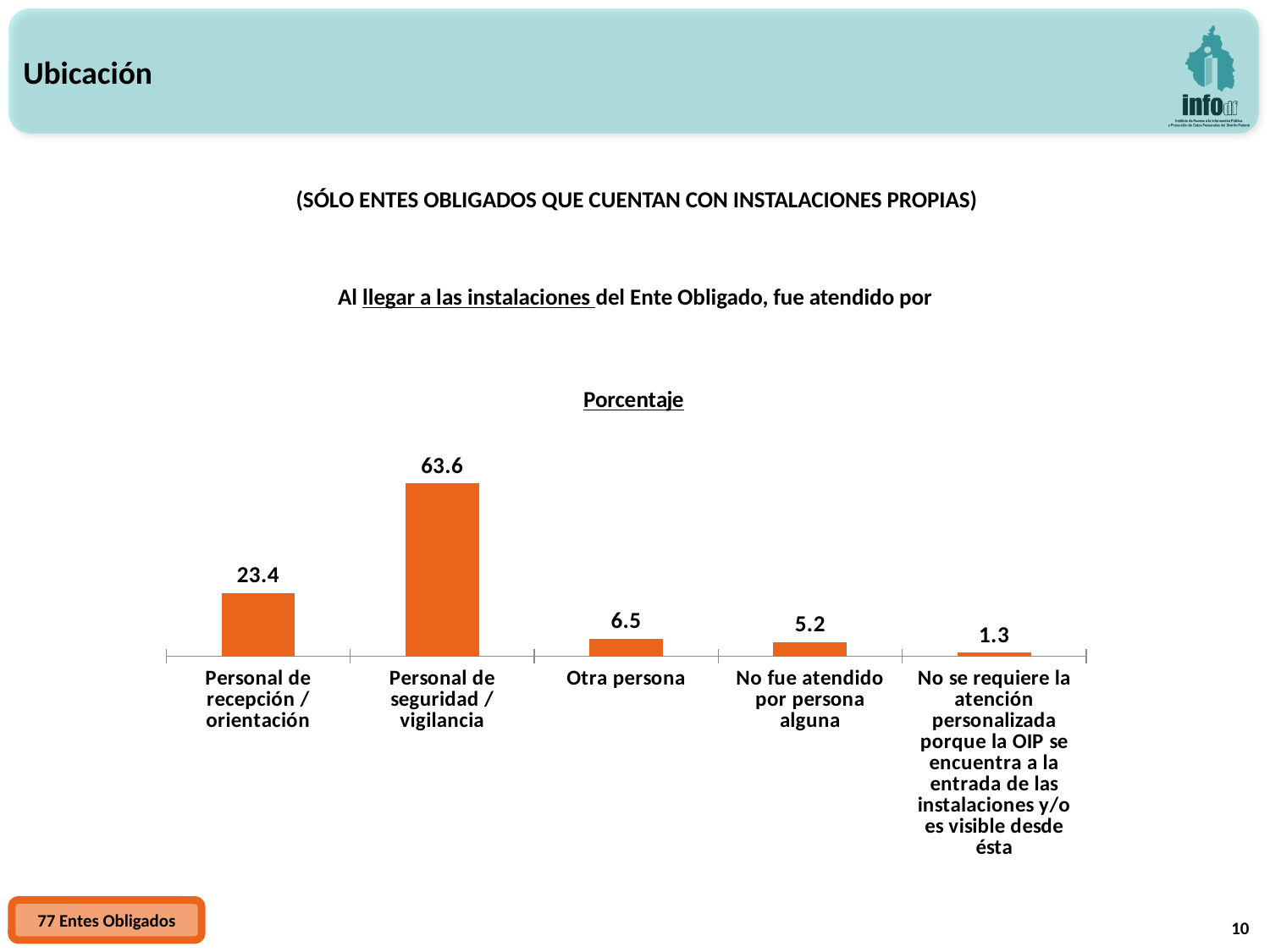
What is the value for "Otra persona"? 6.5 Which category has the lowest value? No se requiere la atención personalizada porque la OIP se encuentra a la entrada de las instalaciones y/o es visible desde ésta Which category has the highest value? Personal de seguridad / vigilancia What kind of chart is shown on the slide? Bar chart Which is larger, the value for "Otra persona" or the value for "No fue atendido por persona alguna"? Otra persona How many categories are shown in the chart? 5 What is the value for "No fue atendido por persona alguna"? 5.2 What is the label shown above the chart indicating the unit of the values? Porcentaje What is the difference between the values for "Personal de seguridad / vigilancia" and "Personal de recepción / orientación"? 40.2 What is the value for "Personal de recepción / orientación"? 23.4 What is the difference between the values for "Otra persona" and "No fue atendido por persona alguna"? 1.3 What is the value for "Personal de seguridad / vigilancia"? 63.6